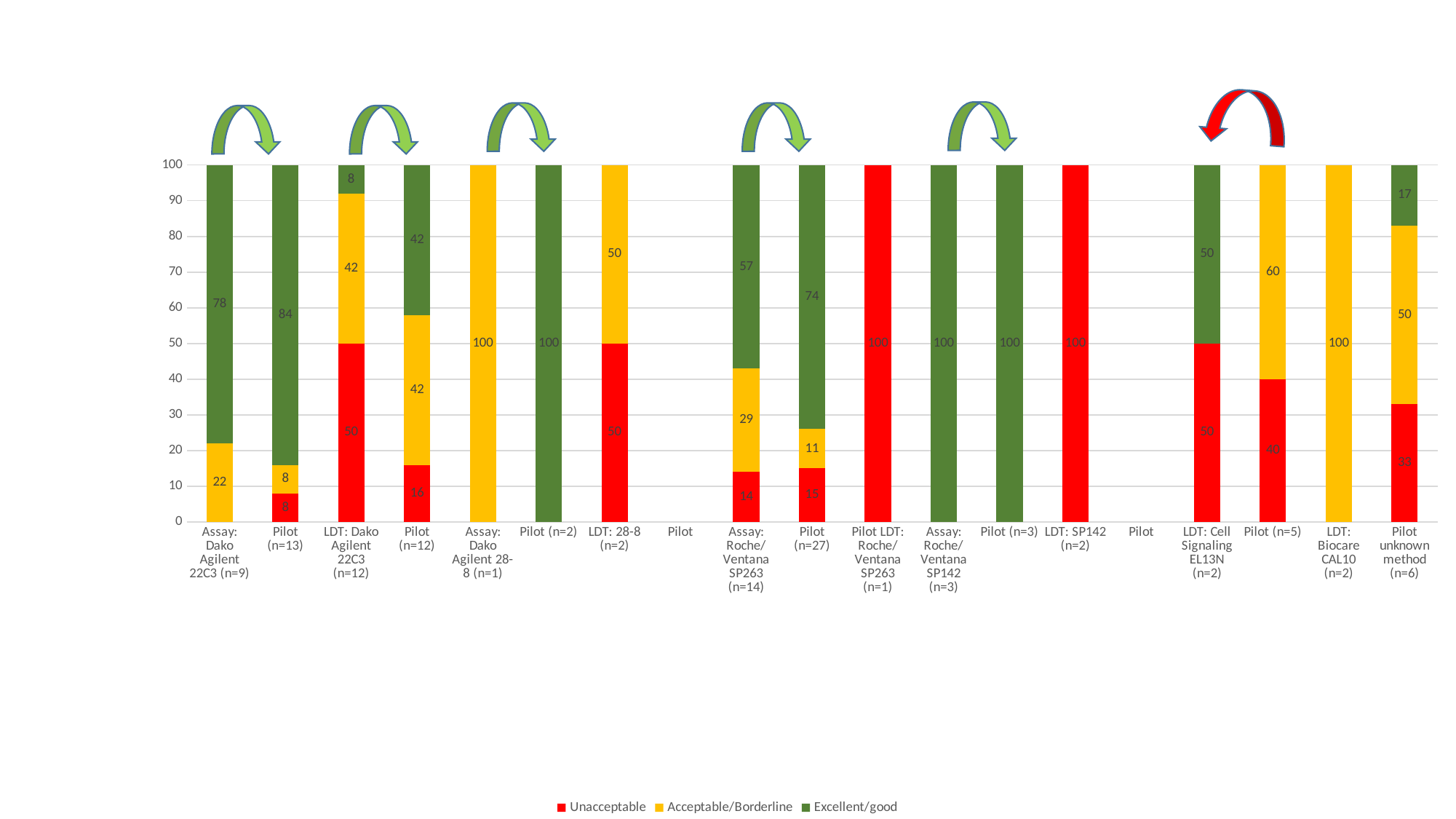
What is the Unacceptable value for LDT: Dako Agilent 22C3 (n=12)? 50 What is the difference between the Excellent/good value for Pilot (n=27) and the Excellent/good value for Assay: Roche/Ventana SP263 (n=14)? 17 What is the Acceptable/Borderline value for Pilot (n=5)? 60 What is the Excellent/good value for Assay: Dako Agilent 22C3 (n=9)? 78 What are the three series named in the legend? Unacceptable, Acceptable/Borderline, Excellent/good What is the Unacceptable value for Pilot unknown method (n=6)? 33 How many series does the legend list? 3 What is the Acceptable/Borderline value for Assay: Roche/Ventana SP263 (n=14)? 29 What kind of chart is shown on the slide? Stacked bar chart What is the Acceptable/Borderline value for LDT: Biocare CAL10 (n=2)? 100 Which has the larger Excellent/good value: Pilot (n=13) or Assay: Dako Agilent 22C3 (n=9)? Pilot (n=13) What is the total of the stacked bar for Pilot (n=12)? 100